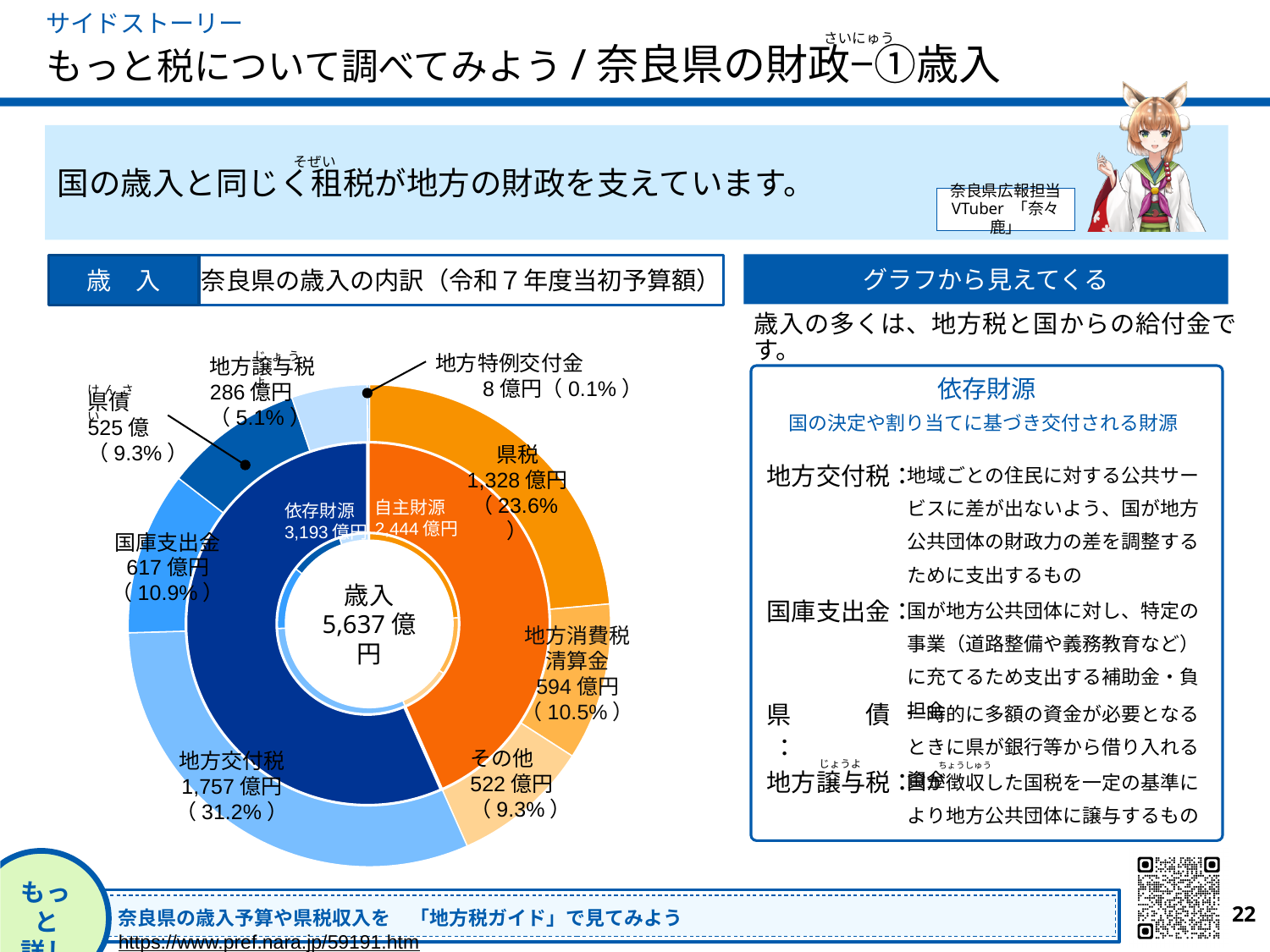
What is the percentage share shown for 地方譲与税? 5.1% Which category has the smallest share in the chart? 地方特例交付金 What percentage share does 県税 have in the chart? 23.6% What is the value shown for 地方交付税 in the chart? 1,757 億円 What is the difference in 億円 between 地方交付税 and 県税? 429 億円 What kind of chart is shown on the slide? Donut (pie) chart How many categories are shown in the outer ring of the chart? 8 What is the value shown for 国庫支出金? 617 億円 What is the total 歳入 shown in the centre of the chart? 5,637 億円 Which is larger, 地方消費税清算金 or 国庫支出金? 国庫支出金 What is the value shown for 依存財源 in the inner ring? 3,193 億円 Which category has the largest share in the chart? 地方交付税